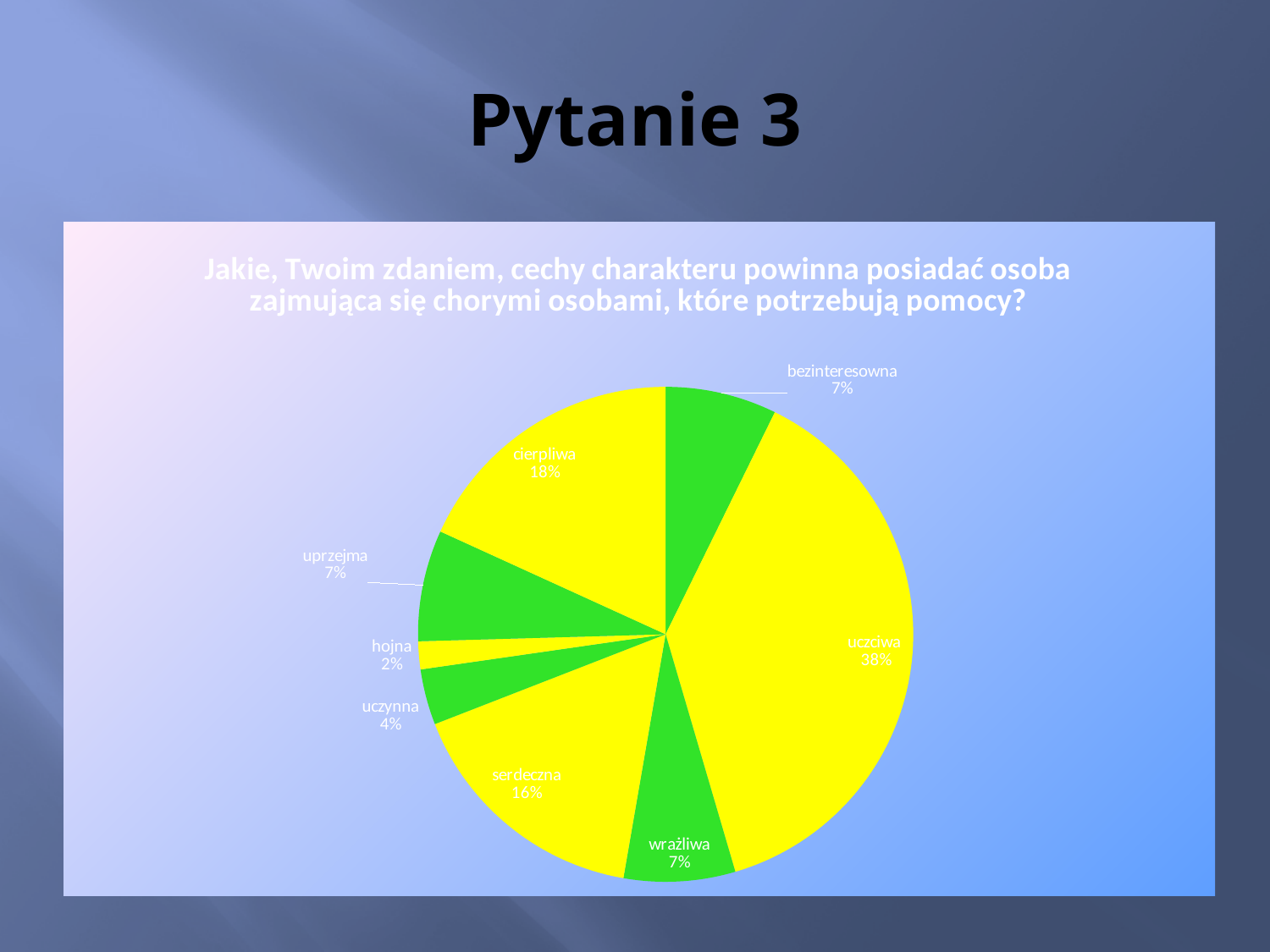
What share of the pie does "hojna" have? 2% Which category has the largest slice of the pie? uczciwa Which has a larger share, "serdeczna" or "cierpliwa"? cierpliwa Which category has the smallest slice of the pie? hojna What share of the pie does "serdeczna" have? 16% What is the difference between the shares of "uczciwa" and "cierpliwa"? 20% What share of the pie does "uczciwa" have? 38% What kind of chart is shown on the slide? pie chart What is the title of the slide? Pytanie 3 How many categories are shown in the pie chart? 8